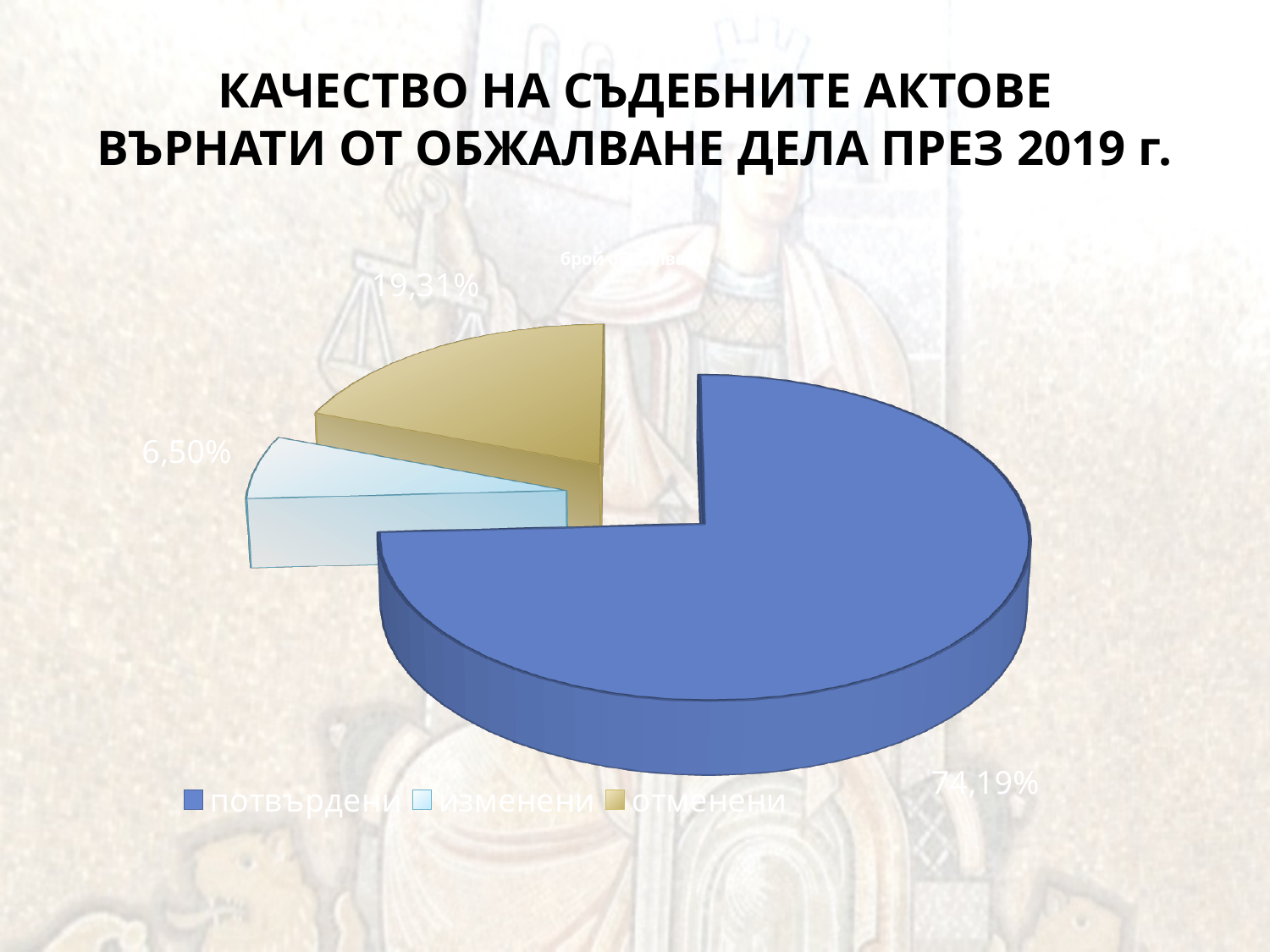
What kind of chart is shown on the slide? pie chart What percentage is shown for the "потвърдени" slice? 74,19% How many entries does the legend list? 3 Which category has the smallest share of the pie? изменени Which is larger, the share for "отменени" or the share for "изменени"? отменени What colour is the "отменени" slice? gold What is the difference in percentage points between the "потвърдени" and "отменени" slices? 54,88 What is the difference in percentage points between the "отменени" and "изменени" slices? 12,81 What percentage is shown for the "отменени" slice? 19,31% Which category has the largest share of the pie? потвърдени What percentage is shown for the "изменени" slice? 6,50% How many slices does the pie chart have? 3